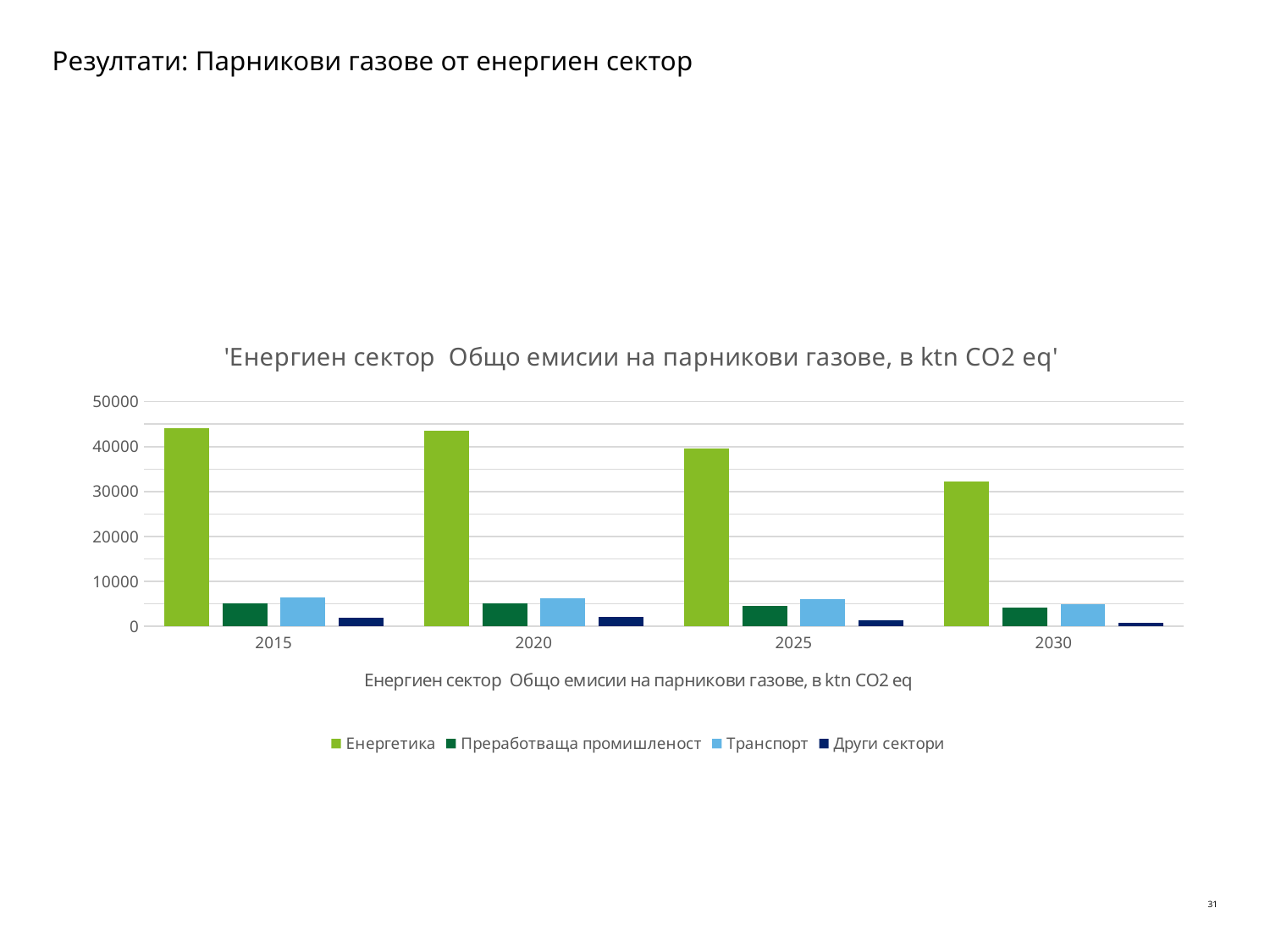
What is the title of the chart? 'Енергиен сектор Общо емисии на парникови газове, в ktn CO2 eq' Is the value for Транспорт in 2015 greater or less than 10000? less Is the value for Енергетика in 2030 greater or less than 40000? less Which series has the lowest value in 2030? Други сектори In 2015, which is larger: Транспорт or Преработваща промишленост? Транспорт Do the values for Енергетика rise or fall from 2015 to 2030? fall Is the value for Енергетика in 2030 greater or less than 30000? greater Which series has the highest value in 2015? Енергетика How many year categories are shown on the x axis? 4 How many series does the legend list? 4 What kind of chart is shown on the slide? bar chart